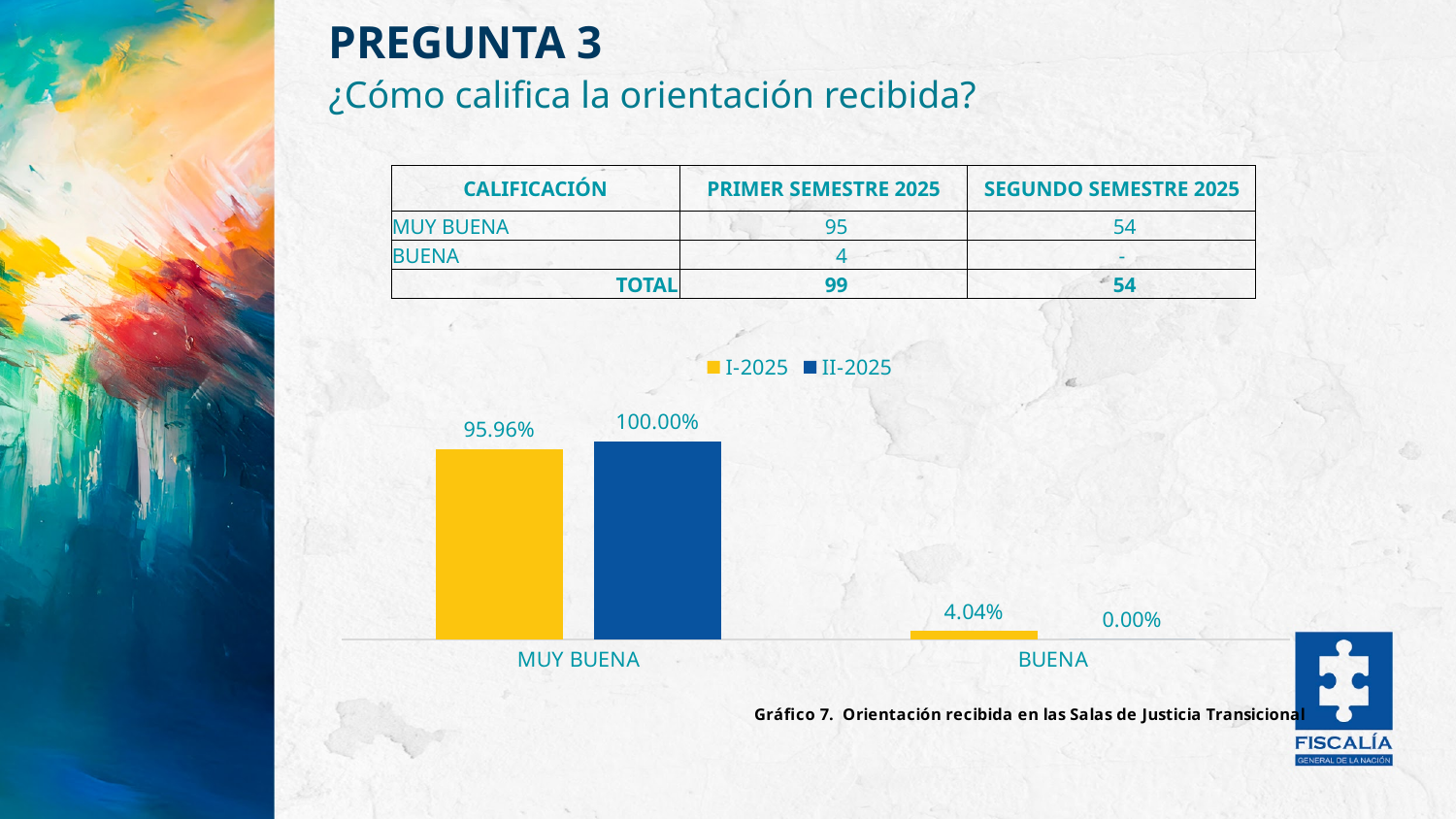
What is the value for MUY BUENA in the I-2025 series? 95.96% What is the difference between the I-2025 values for MUY BUENA and BUENA? 91.92% What is the value for BUENA in the II-2025 series? 0.00% What is the value for MUY BUENA in the II-2025 series? 100.00% What is the caption of the chart shown below the table? Gráfico 7. Orientación recibida en las Salas de Justicia Transicional For MUY BUENA, which series has the larger value, I-2025 or II-2025? II-2025 How many categories are shown on the x axis of the chart? 2 What kind of chart is shown on the slide? bar chart Which category has the highest value in the II-2025 series? MUY BUENA How many series does the chart legend list? 2 Which category has the lowest value in the I-2025 series? BUENA What is the value for BUENA in the I-2025 series? 4.04%